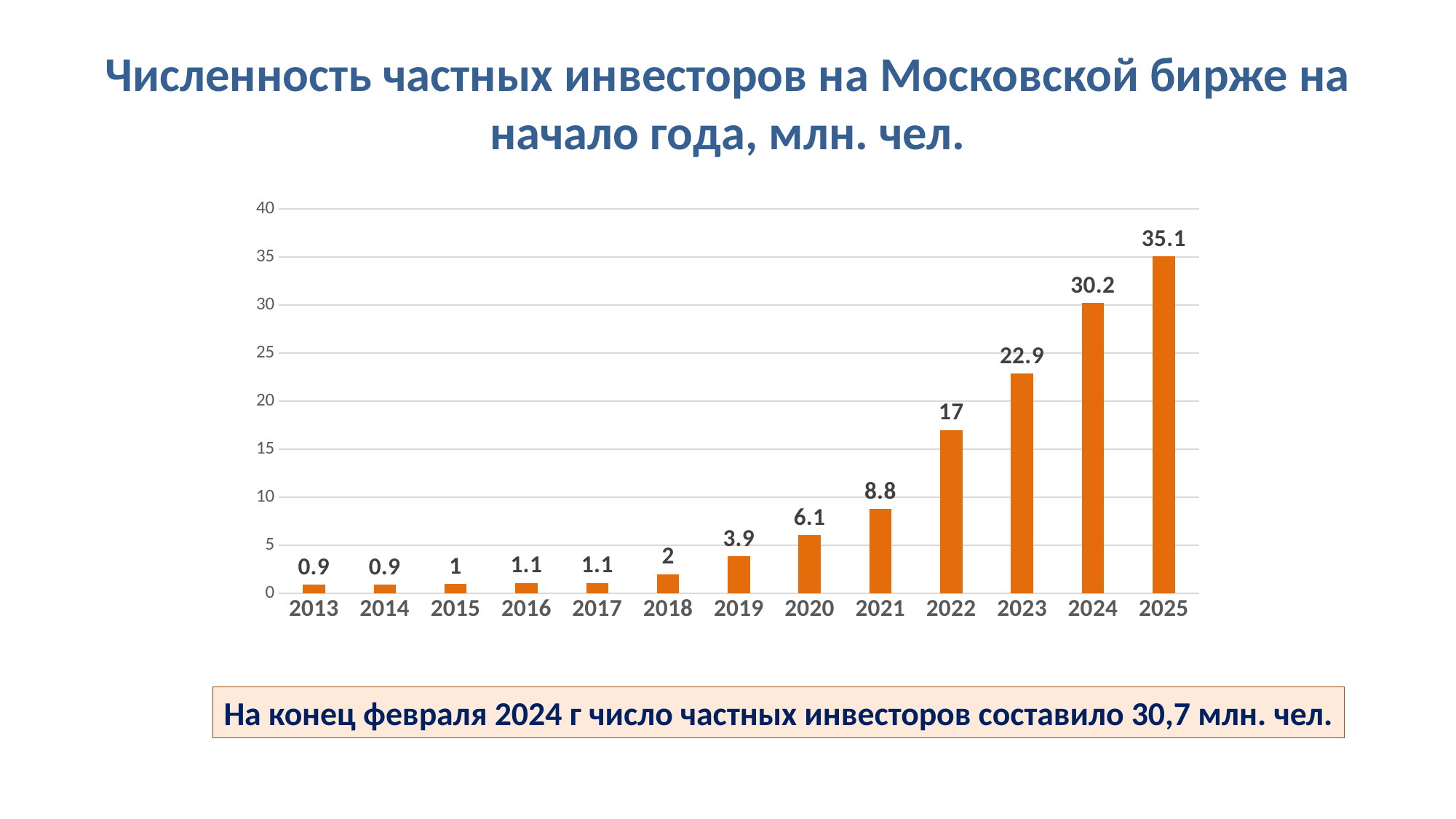
How many years are shown on the x axis? 13 What colour are the bars in the chart? orange What is the value for 2018? 2 What is the value for 2020? 6.1 Do the values rise or fall from 2013 to 2025? rise What kind of chart is shown on the slide? bar chart Which is larger, the value for 2019 or the value for 2021? 2021 What is the difference between the values for 2025 and 2024? 4.9 Which year has the highest value? 2025 Is the value for 2024 greater or less than 25? greater What is the difference between the values for 2022 and 2021? 8.2 What is the value for 2023? 22.9